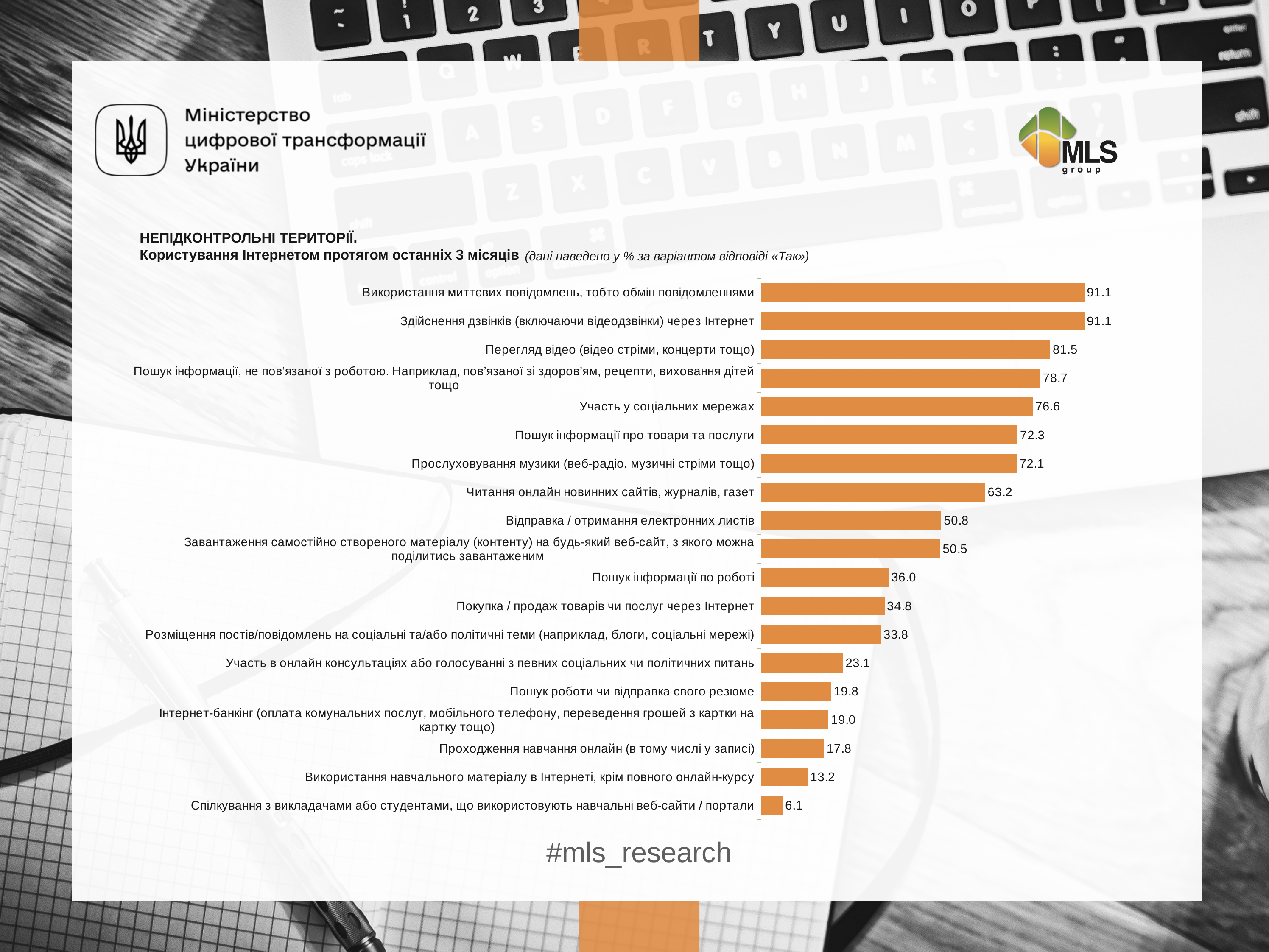
How many categories are shown in the chart? 19 What is the value for «Участь у соціальних мережах»? 76.6 What is the value for «Інтернет-банкінг (оплата комунальних послуг, мобільного телефону, переведення грошей з картки на картку тощо)»? 19.0 What is the value for «Перегляд відео (відео стріми, концерти тощо)»? 81.5 Which is larger: the value for «Пошук роботи чи відправка свого резюме» or the value for «Проходження навчання онлайн (в тому числі у записі)»? Пошук роботи чи відправка свого резюме What is the value for «Пошук інформації по роботі»? 36.0 Which is larger: the value for «Читання онлайн новинних сайтів, журналів, газет» or the value for «Покупка / продаж товарів чи послуг через Інтернет»? Читання онлайн новинних сайтів, журналів, газет Which category has the lowest value? Спілкування з викладачами або студентами, що використовують навчальні веб-сайти / портали What is the difference between the values for «Перегляд відео (відео стріми, концерти тощо)» and «Участь у соціальних мережах»? 4.9 What colour are the bars in the chart? Orange What is the difference between the values for «Читання онлайн новинних сайтів, журналів, газет» and «Відправка / отримання електронних листів»? 12.4 What kind of chart is shown on the slide? Bar chart